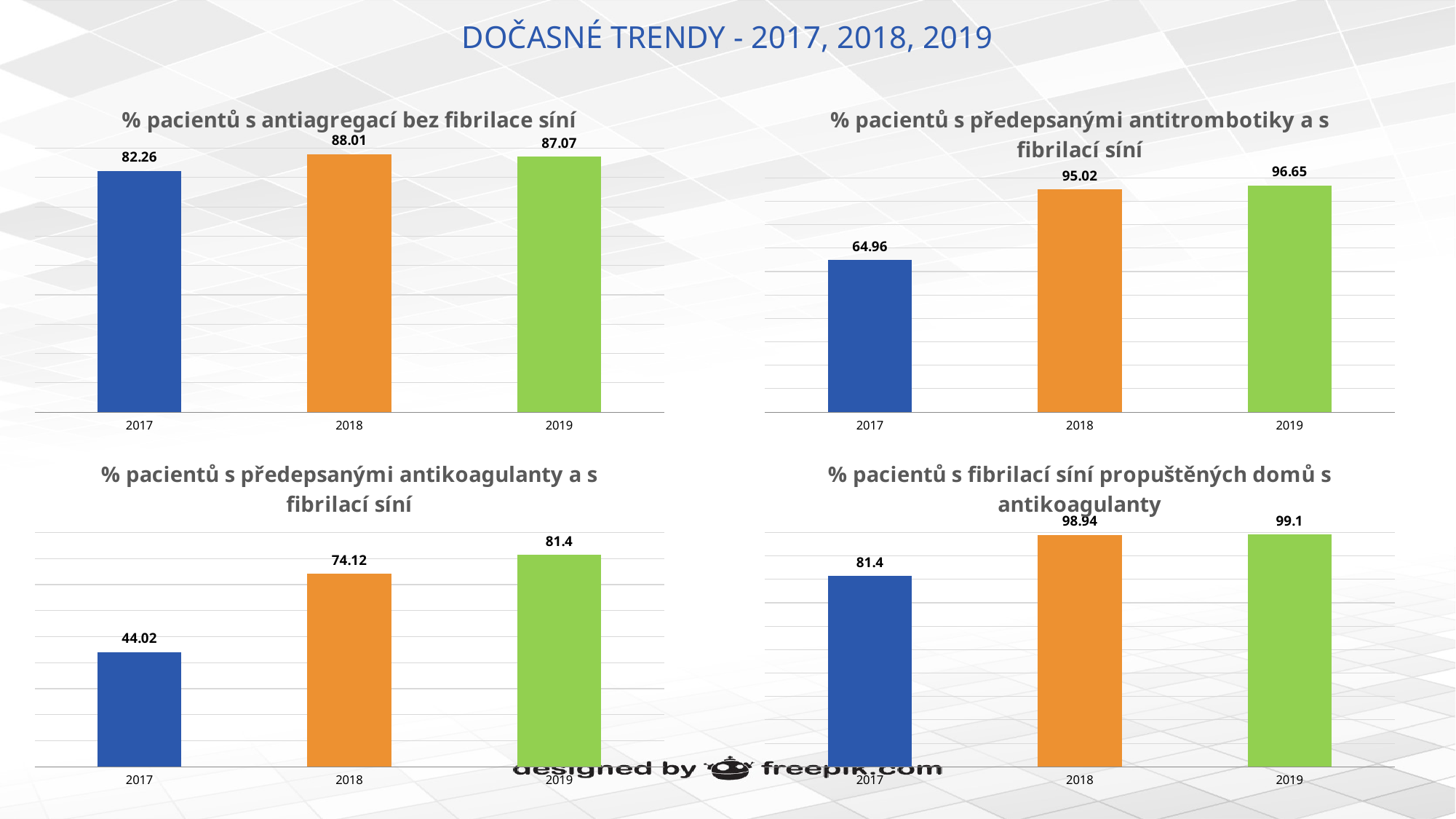
In the top-right chart (% pacientů s předepsanými antitrombotiky a s fibrilací síní), what is the difference between the 2018 and 2017 values? 30.06 In the bottom-right chart (% pacientů s fibrilací síní propuštěných domů s antikoagulanty), which is larger, the value for 2017 or the value for 2019? 2019 In the top-right chart (% pacientů s předepsanými antitrombotiky a s fibrilací síní), which year has the lowest value? 2017 In the top-right chart (% pacientů s předepsanými antitrombotiky a s fibrilací síní), what is the value for 2019? 96.65 How many bars does the top-left chart (% pacientů s antiagregací bez fibrilace síní) have? 3 In the bottom-left chart (% pacientů s předepsanými antikoagulanty a s fibrilací síní), what is the difference between the 2019 and 2018 values? 7.28 In the top-left chart (% pacientů s antiagregací bez fibrilace síní), what is the value for 2017? 82.26 In the top-left chart (% pacientů s antiagregací bez fibrilace síní), which year has the highest value? 2018 In the bottom-left chart (% pacientů s předepsanými antikoagulanty a s fibrilací síní), what is the value for 2017? 44.02 In the bottom-right chart (% pacientů s fibrilací síní propuštěných domů s antikoagulanty), what is the value for 2018? 98.94 In the bottom-left chart (% pacientů s předepsanými antikoagulanty a s fibrilací síní), do the values rise or fall from 2017 to 2019? rise What type of chart is the bottom-right chart (% pacientů s fibrilací síní propuštěných domů s antikoagulanty)? bar chart